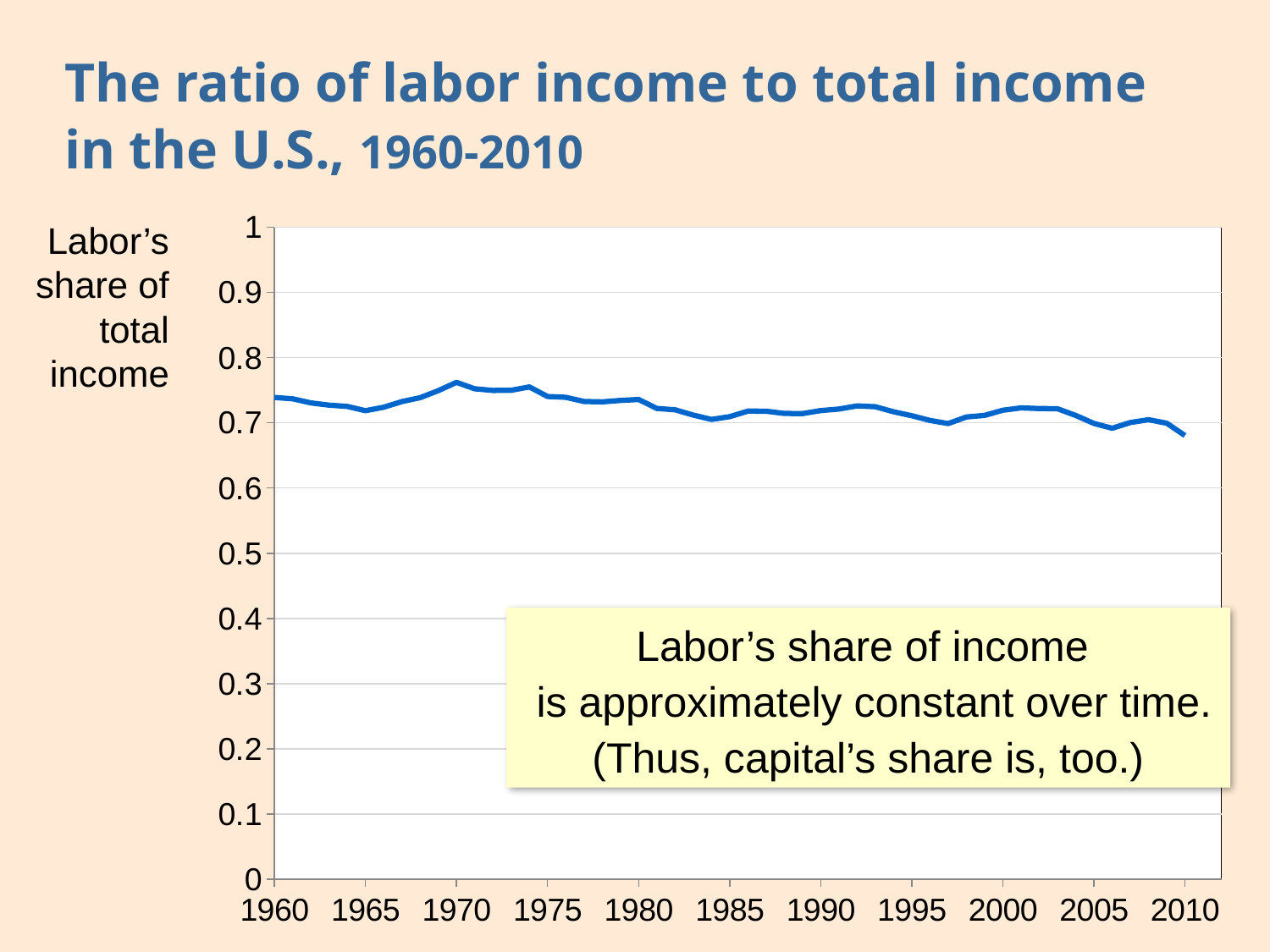
What is the label on the vertical axis of the chart? Labor's share of total income Is the value for 1960 greater or less than 0.8? less Is the value for 1990 greater or less than 0.6? greater Does the line end in 2010 higher or lower than it starts in 1960? lower Which is larger, the value for 1970 or the value for 2010? 1970 Around which labeled year does the line reach its highest point? 1970 Is the value for 1970 greater or less than 0.7? greater How many year labels are shown along the x axis? 11 How many lines (data series) are plotted on the chart? 1 What is the title of the chart? The ratio of labor income to total income in the U.S., 1960-2010 What kind of chart is shown on the slide? line chart